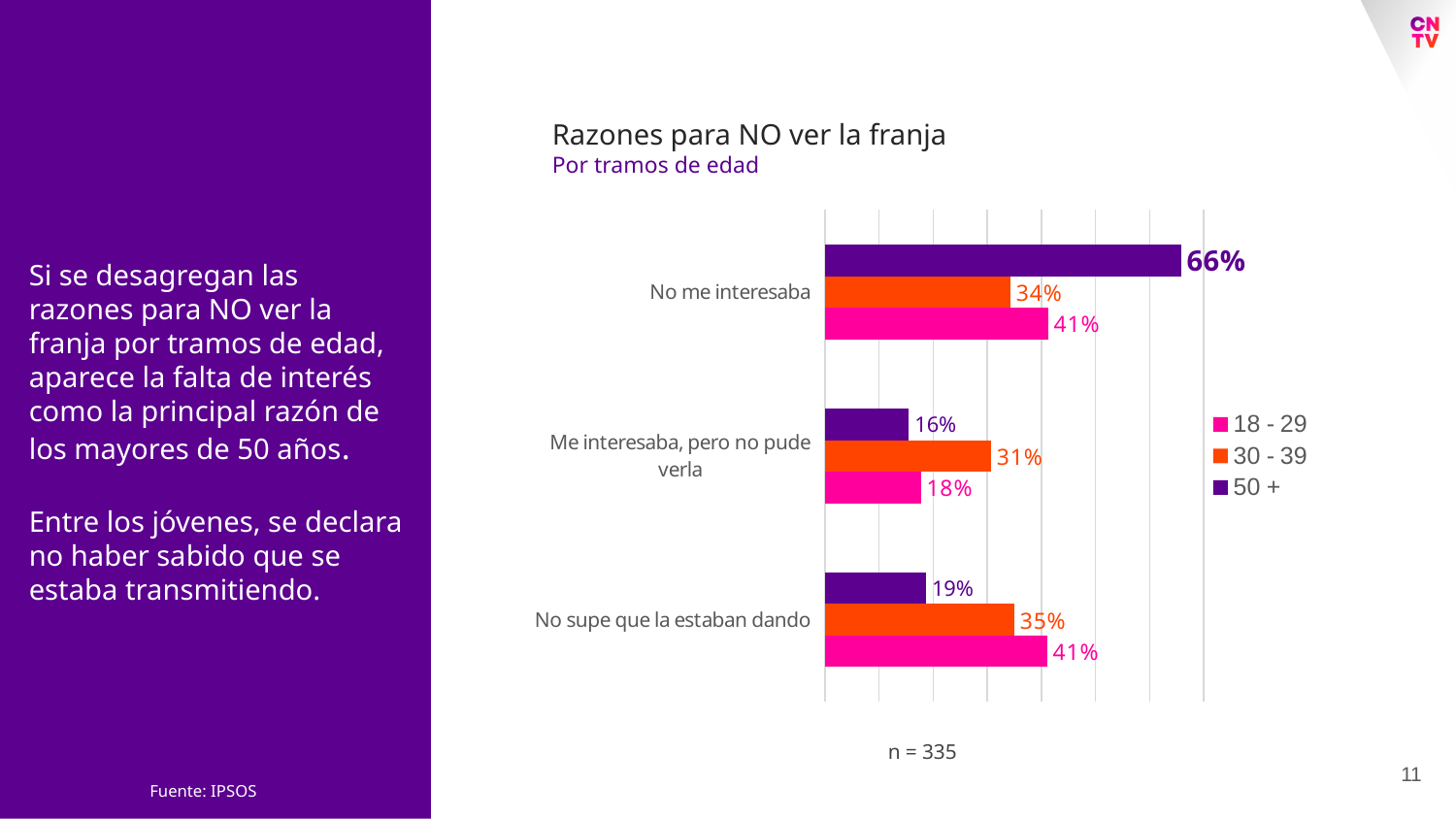
What is the title of the chart? Razones para NO ver la franja What is the value for the 18 - 29 group for "No supe que la estaban dando"? 41% What is the value for the 30 - 39 group for "Me interesaba, pero no pude verla"? 31% What type of chart is shown on the slide? Bar chart Which age group has the lowest value for "Me interesaba, pero no pude verla"? 50 + What is the difference between the 50 + and 18 - 29 values for "No me interesaba"? 25% What is the value for the 50 + group for "No supe que la estaban dando"? 19% Which age group has the highest value for "No me interesaba"? 50 + What is the value for the 50 + group for "No me interesaba"? 66% How many age groups does the legend list? 3 Which is larger for "No supe que la estaban dando": the 30 - 39 value or the 50 + value? 30 - 39 How many reason categories are shown in the chart? 3